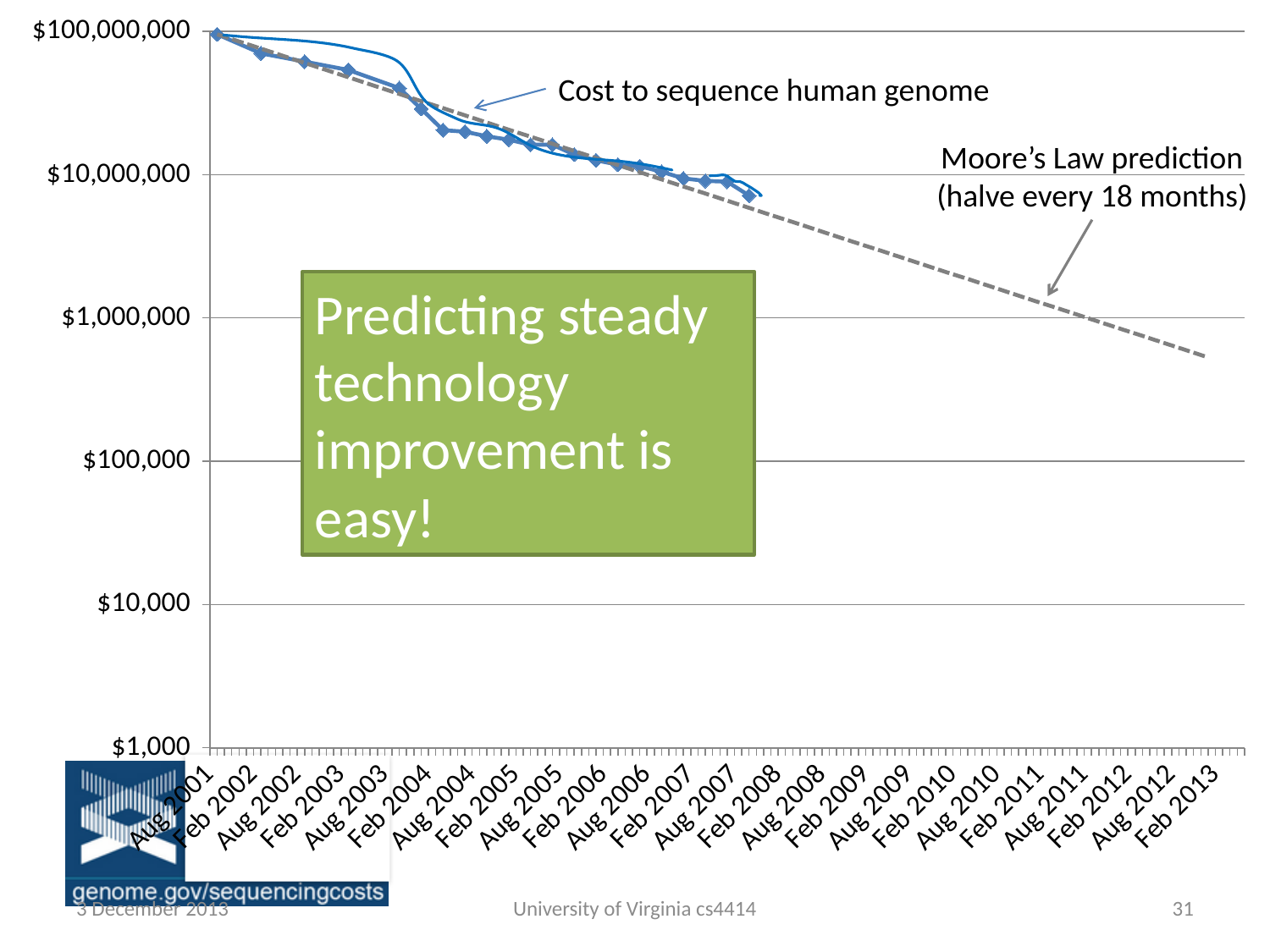
In Aug 2007, which is higher: the actual cost to sequence a human genome or the Moore's Law prediction? Cost to sequence human genome How many date labels are shown on the x axis? 24 What kind of chart is shown on the slide? line chart How many data series are plotted on the chart? 2 Is the cost to sequence a human genome in Aug 2004 greater or less than $10,000,000? greater Does the cost to sequence a human genome rise or fall over time along the x axis? fall What is the highest value labeled on the y axis? $100,000,000 What does the gray dashed line represent? Moore's Law prediction (halve every 18 months) Is the Moore's Law prediction for Feb 2013 greater or less than $100,000? greater Is the Moore's Law prediction for Feb 2013 greater or less than $1,000,000? less What does the solid blue line with diamond markers represent? Cost to sequence human genome